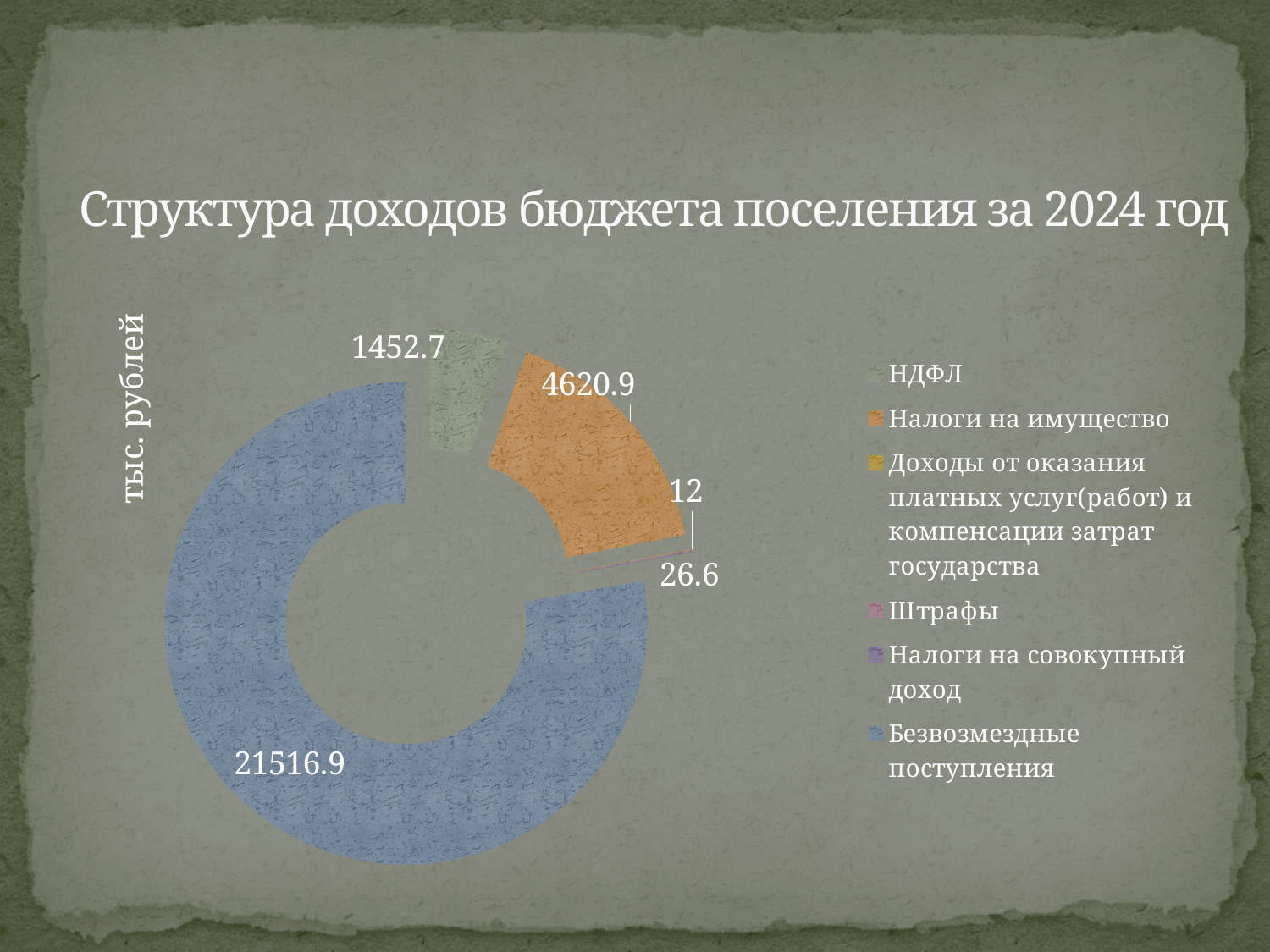
Which category has the largest share of the chart? Безвозмездные поступления How many categories does the legend list? 6 What is the difference between Безвозмездные поступления and Налоги на имущество? 16896 In what units are the values on the chart given, according to the label on the left? тыс. рублей What kind of chart is shown on the slide? Doughnut (pie) chart What is the value for НДФЛ? 1452.7 Which is larger, НДФЛ or Налоги на имущество? Налоги на имущество What is the difference between Налоги на имущество and НДФЛ? 3168.2 What is the value for Безвозмездные поступления? 21516.9 What is the value for Налоги на имущество? 4620.9 What is the smallest value printed on the chart? 12 What is the title of the chart? Структура доходов бюджета поселения за 2024 год